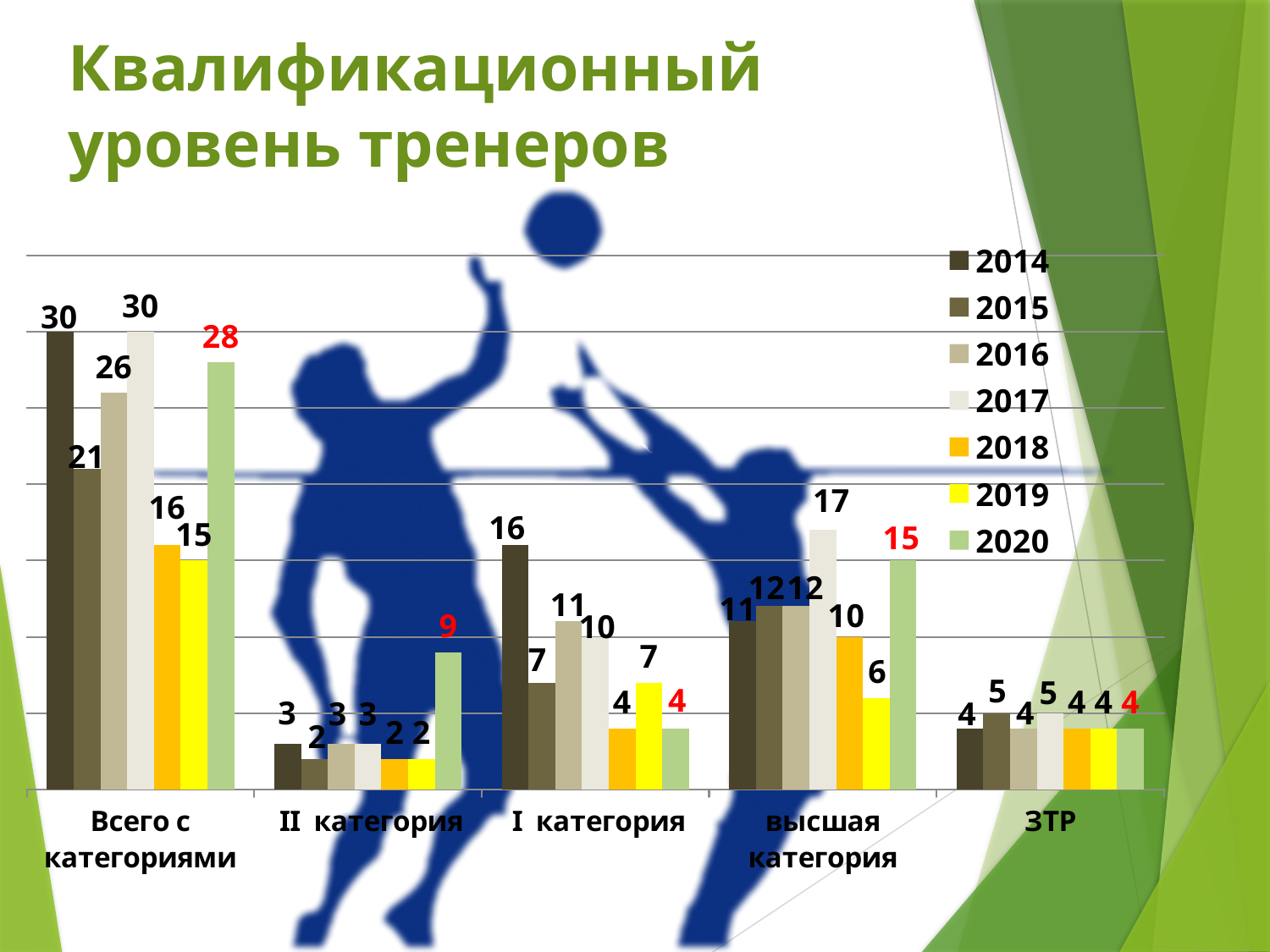
What is the value for 2017 in the "высшая категория" category? 17 What is the title of the slide? Квалификационный уровень тренеров What is the value for 2014 in the "I категория" category? 16 What is the value for 2020 in the "Всего с категориями" category? 28 What is the value for 2020 in the "II категория" category? 9 What is the difference between the 2014 and 2015 values in the "Всего с категориями" category? 9 Which year has the highest value in the "высшая категория" category? 2017 How many series does the legend list? 7 What kind of chart is shown on the slide? Bar chart Which year has the lowest value in the "I категория" category? 2018 and 2020 How many categories are shown on the x axis? 5 Which is larger in the "высшая категория" category: the value for 2020 or the value for 2018? 2020